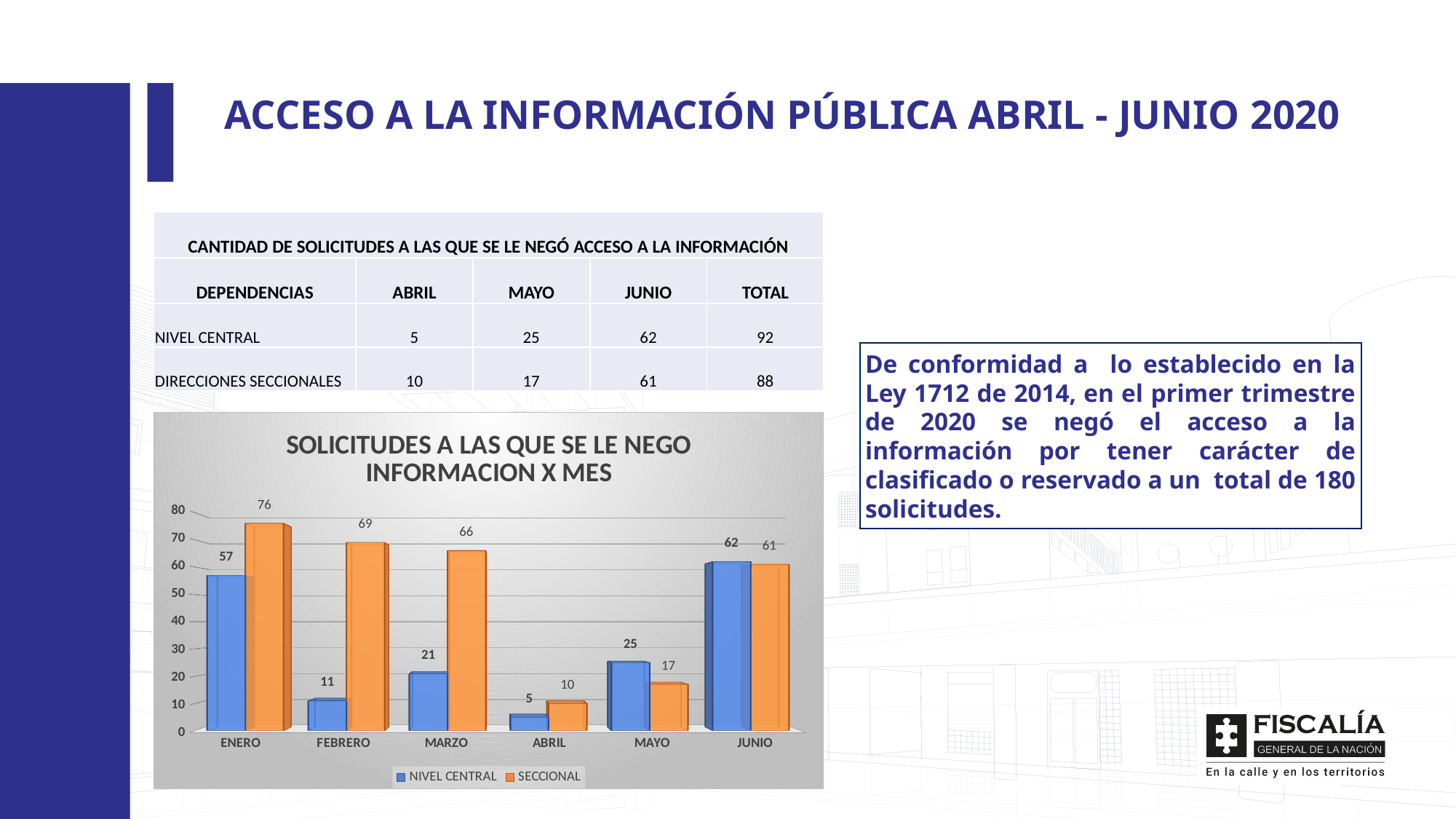
In which month is the NIVEL CENTRAL value lowest? ABRIL How many series does the chart legend list? 2 What is the value for NIVEL CENTRAL in ENERO? 57 How many months are shown on the x axis of the chart? 6 What type of chart is shown on the slide? bar chart What is the difference between the SECCIONAL and NIVEL CENTRAL values in MARZO? 45 What is the title of the chart? SOLICITUDES A LAS QUE SE LE NEGO INFORMACION X MES What is the value for SECCIONAL in FEBRERO? 69 Which is larger in MAYO, NIVEL CENTRAL or SECCIONAL? NIVEL CENTRAL What is the value for NIVEL CENTRAL in MAYO? 25 What is the value for SECCIONAL in JUNIO? 61 In which month is the SECCIONAL value highest? ENERO